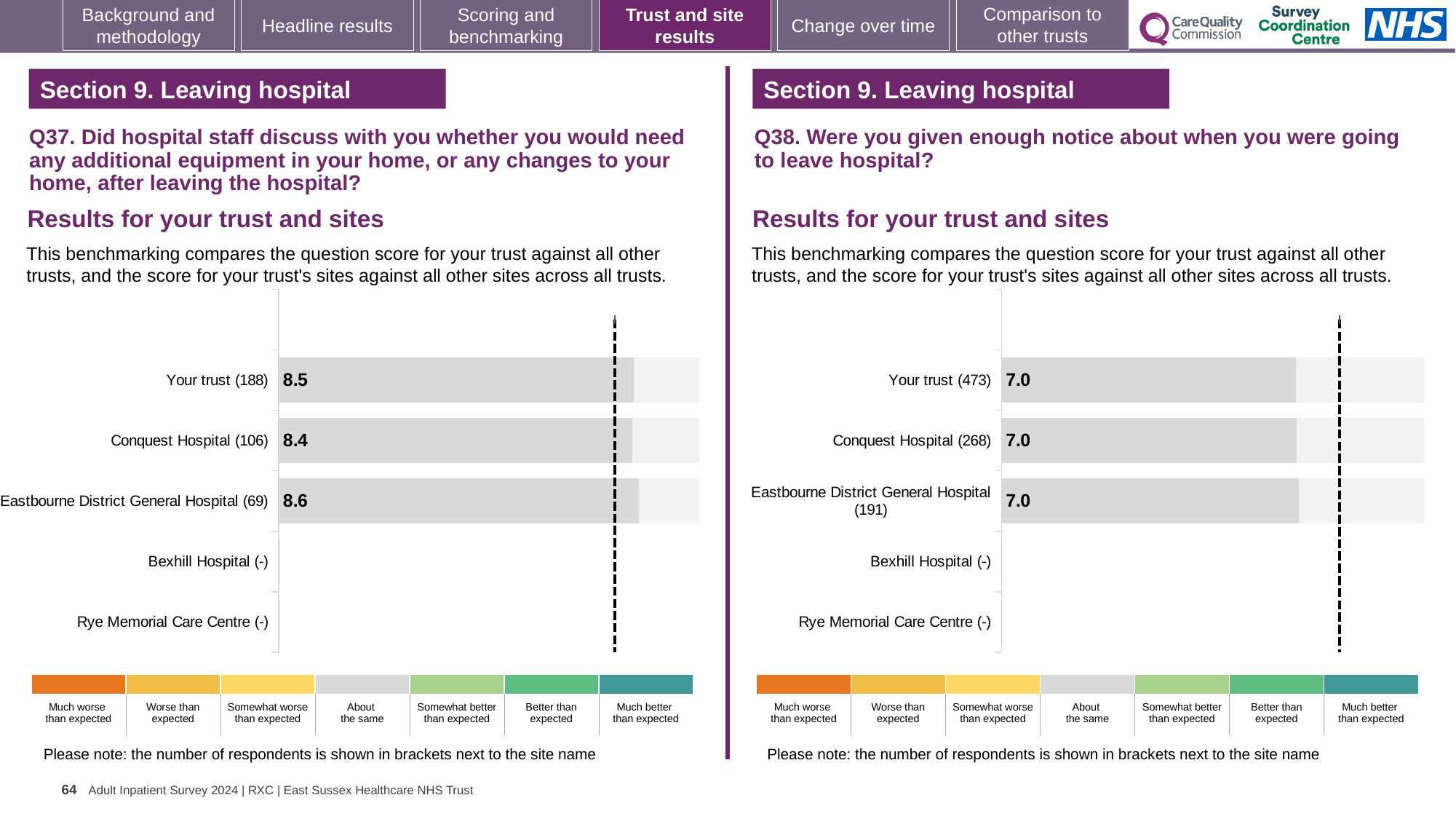
In the Q37 chart on the left, what is the score for Eastbourne District General Hospital? 8.6 In the Q37 chart on the left, which site has the highest score? Eastbourne District General Hospital In the Q38 chart on the right, how many respondents are shown for Conquest Hospital? 268 In the Q37 chart on the left, what is the score for Your trust? 8.5 In the Q38 chart on the right, how many sites or rows are listed on the vertical axis? 5 In the Q37 chart on the left, what is the score for Conquest Hospital? 8.4 In the Q37 chart on the left, which of the scored sites has the lowest score? Conquest Hospital In the Q38 chart on the right, what is the score for Eastbourne District General Hospital? 7.0 In the Q37 chart on the left, what is the difference between the scores for Eastbourne District General Hospital and Conquest Hospital? 0.2 In the Q38 chart on the right, what is the score for Your trust? 7.0 What kind of chart is used in the Q38 chart on the right? Bar chart In the Q37 chart on the left, how many respondents are shown for Your trust? 188